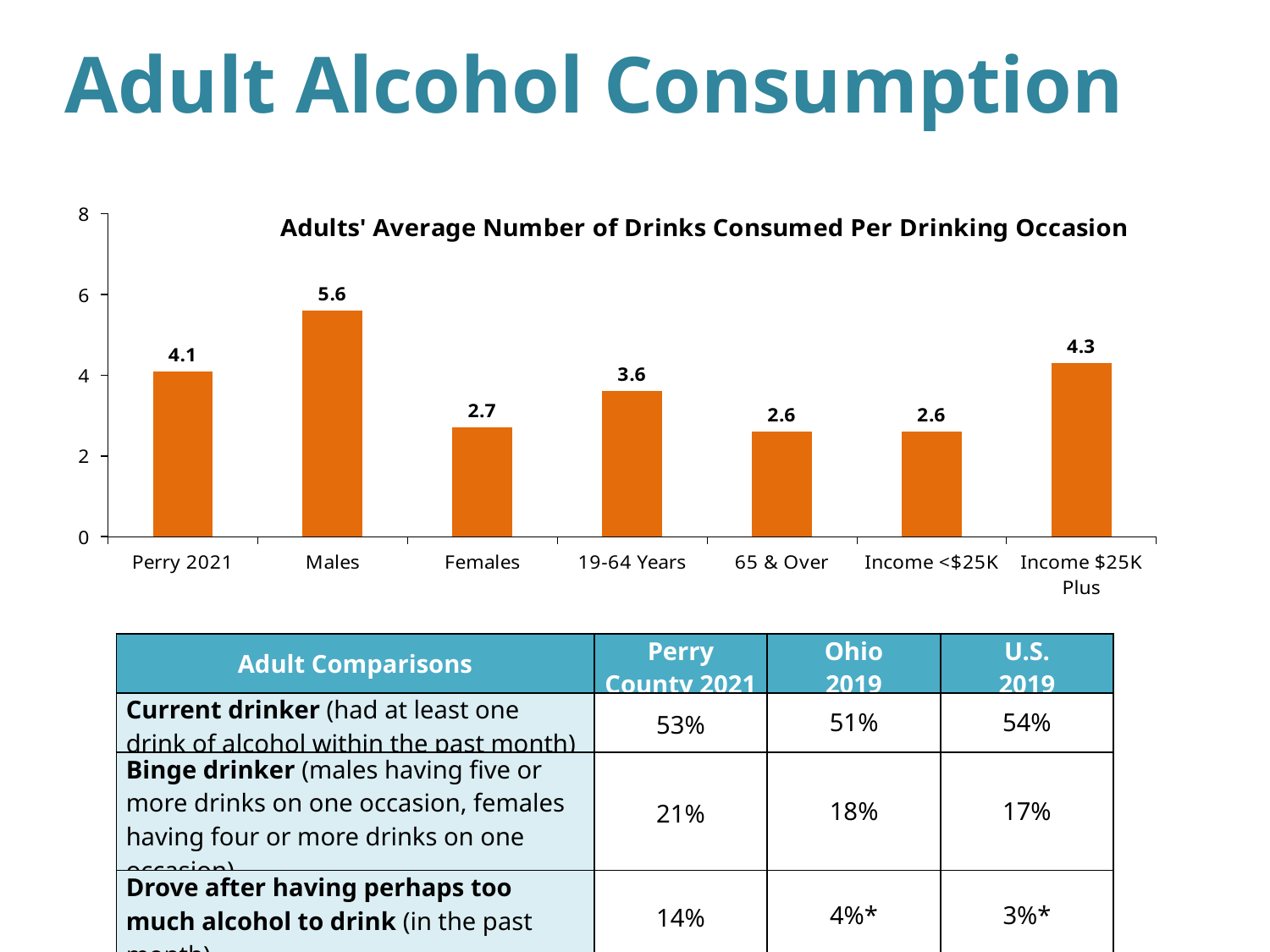
What is the difference between the values for Income $25K Plus and Income <$25K? 1.7 How many categories are shown on the x axis of the chart? 7 What is the value for Income $25K Plus? 4.3 Which is larger, the value for 19-64 Years or the value for 65 & Over? 19-64 Years What is the average number of drinks consumed per drinking occasion for Males? 5.6 Is the value for Females greater or less than 4? less What kind of chart is shown on the slide? Bar chart What colour are the bars in the chart? Orange What is the title of the chart? Adults' Average Number of Drinks Consumed Per Drinking Occasion What is the difference between the values for Males and Females? 2.9 Which category has the highest average number of drinks per drinking occasion? Males What is the value for Perry 2021 in the chart? 4.1